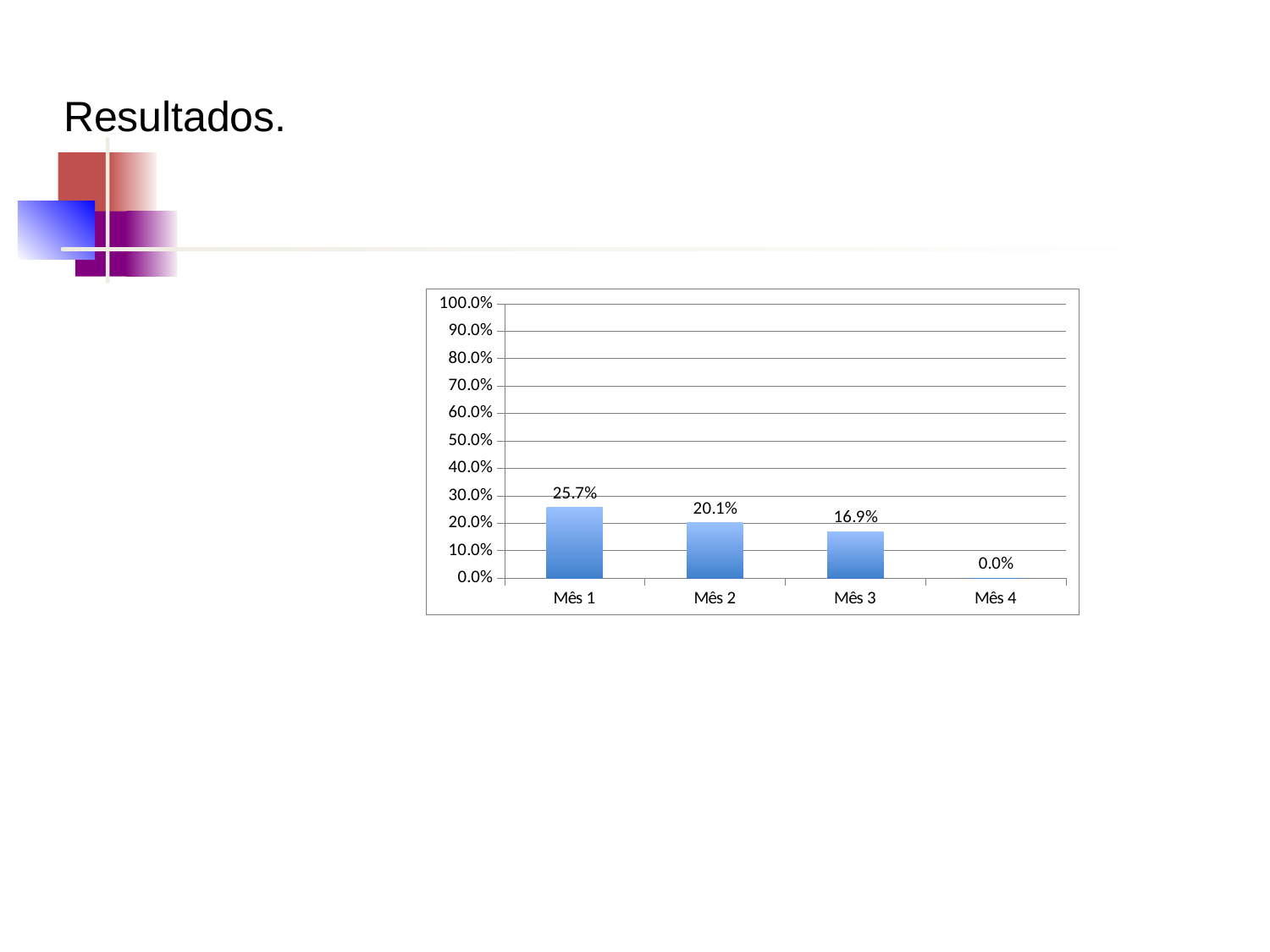
How many categories are shown on the x axis? 4 Which is larger, the value for Mês 2 or the value for Mês 3? Mês 2 What is the difference between the values for Mês 2 and Mês 3? 3.2% What is the value for Mês 1? 25.7% What is the value for Mês 4? 0.0% What is the value for Mês 3? 16.9% What is the value for Mês 2? 20.1% Which category has the highest value? Mês 1 What kind of chart is shown on the slide? bar chart What is the difference between the values for Mês 1 and Mês 2? 5.6% Which category has the lowest value? Mês 4 Is the value for Mês 1 greater or less than 30.0%? less